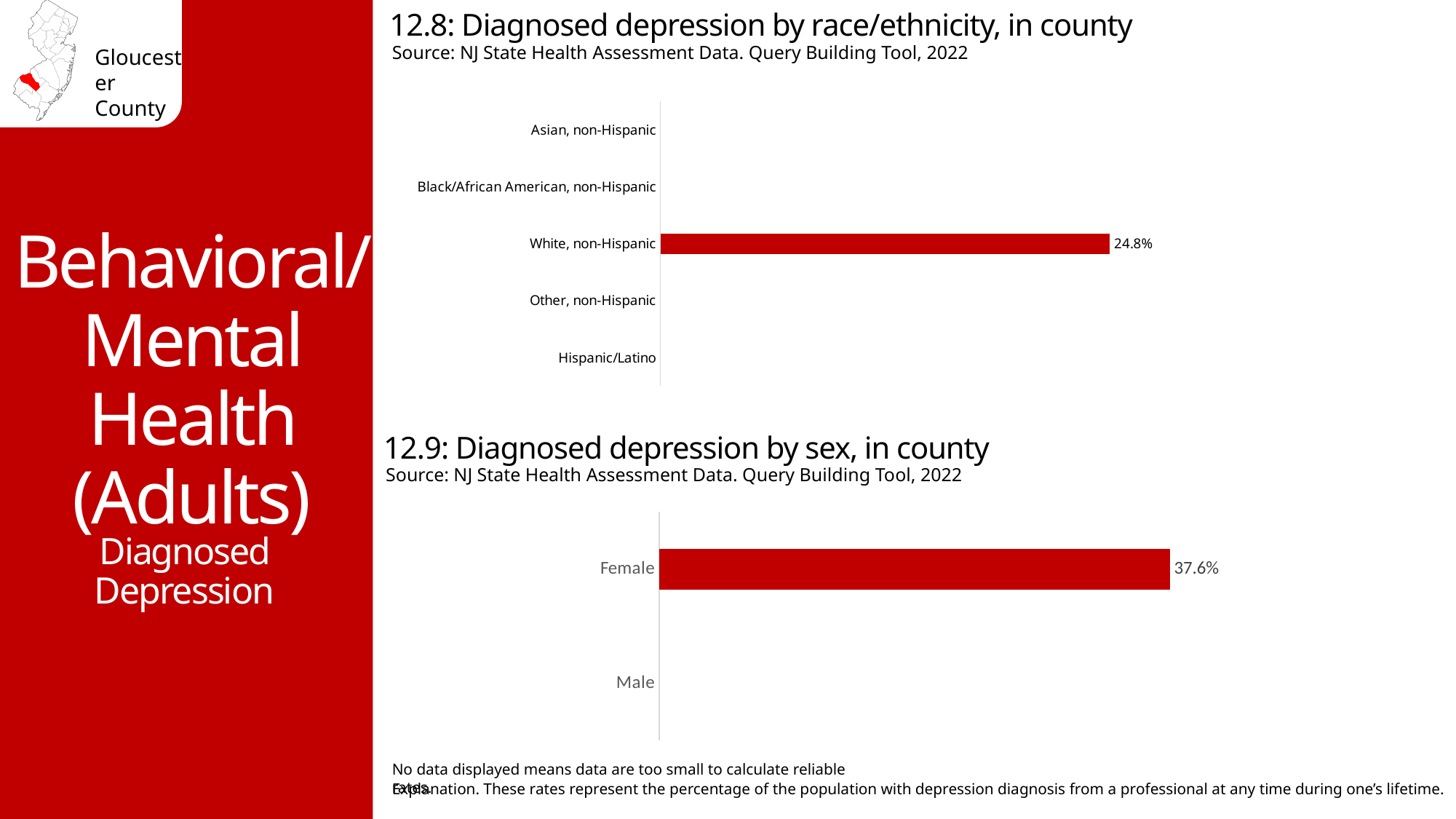
In the chart '12.9: Diagnosed depression by sex, in county', how many categories are listed on the axis? 2 What kind of chart is '12.9: Diagnosed depression by sex, in county'? Bar chart What is the difference between the Female value in chart 12.9 (37.6%) and the White, non-Hispanic value in chart 12.8 (24.8%)? 12.8% What kind of chart is '12.8: Diagnosed depression by race/ethnicity, in county'? Bar chart In the chart '12.8: Diagnosed depression by race/ethnicity, in county', how many race/ethnicity categories are listed on the axis? 5 In the chart '12.9: Diagnosed depression by sex, in county', what is the value for Female? 37.6% In the chart '12.9: Diagnosed depression by sex, in county', which category has a bar displayed? Female What colour are the bars in the chart '12.9: Diagnosed depression by sex, in county'? Red Which is larger: the Female value in chart 12.9 or the White, non-Hispanic value in chart 12.8? Female In the chart '12.8: Diagnosed depression by race/ethnicity, in county', what is the value for White, non-Hispanic? 24.8% What is the source cited for the chart '12.8: Diagnosed depression by race/ethnicity, in county'? NJ State Health Assessment Data. Query Building Tool, 2022 In the chart '12.8: Diagnosed depression by race/ethnicity, in county', which category is the only one with a bar displayed? White, non-Hispanic